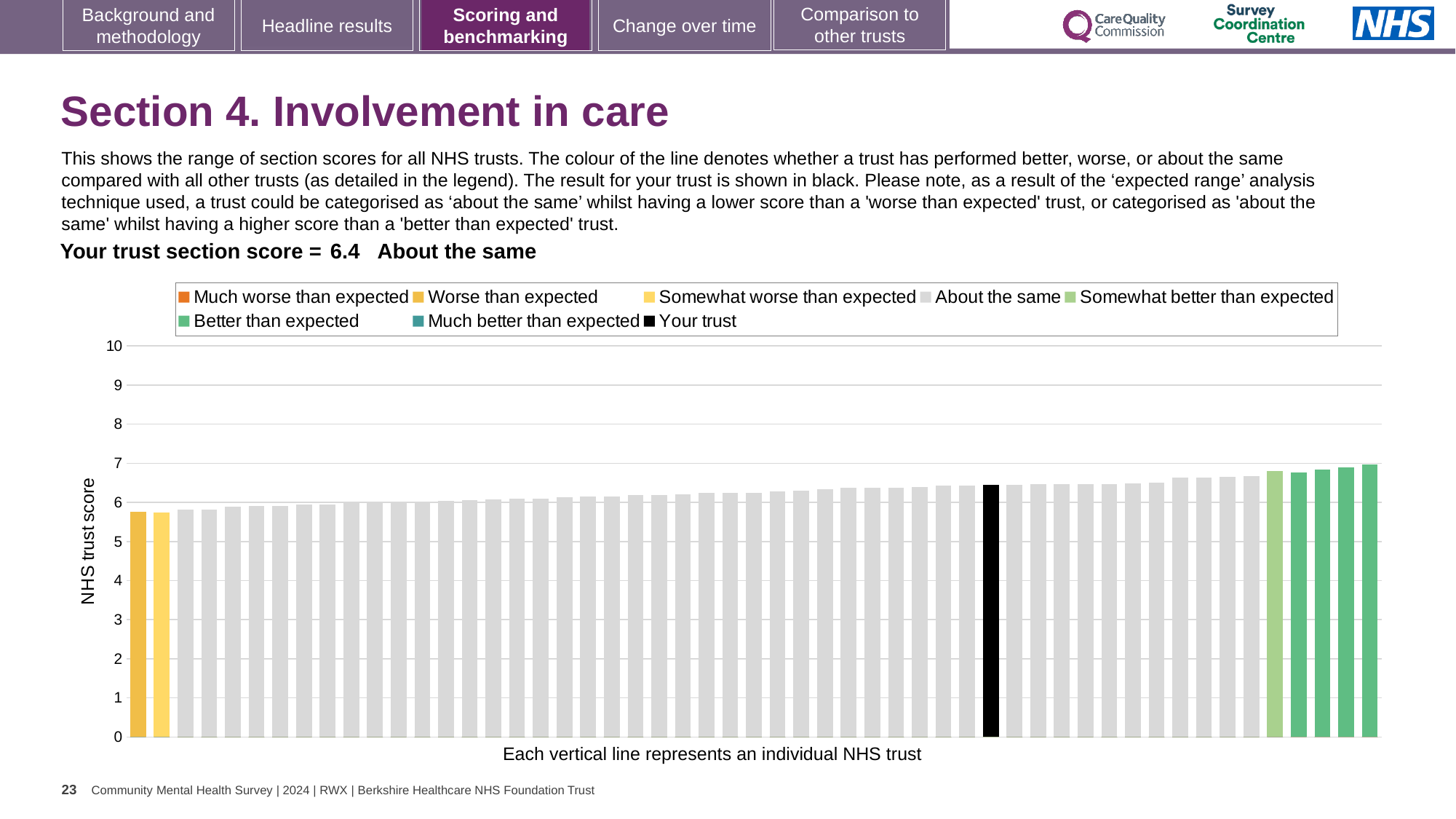
Which bar is taller, the leftmost bar or the rightmost bar? the rightmost bar Is the value of the black bar (your trust) greater or less than 6? greater What colour is the bar representing your trust? black What is the section score for your trust shown on the slide? 6.4 Is the value of the leftmost bar greater or less than 6? less Is the value of the rightmost bar greater or less than 6? greater Which bar is taller, the black bar (your trust) or the leftmost bar? the black bar (your trust) What kind of chart is shown on the slide? bar chart Do the bar values rise or fall from left to right along the x axis? rise How many entries does the chart legend list? 8 What is the label on the vertical axis of the chart? NHS trust score